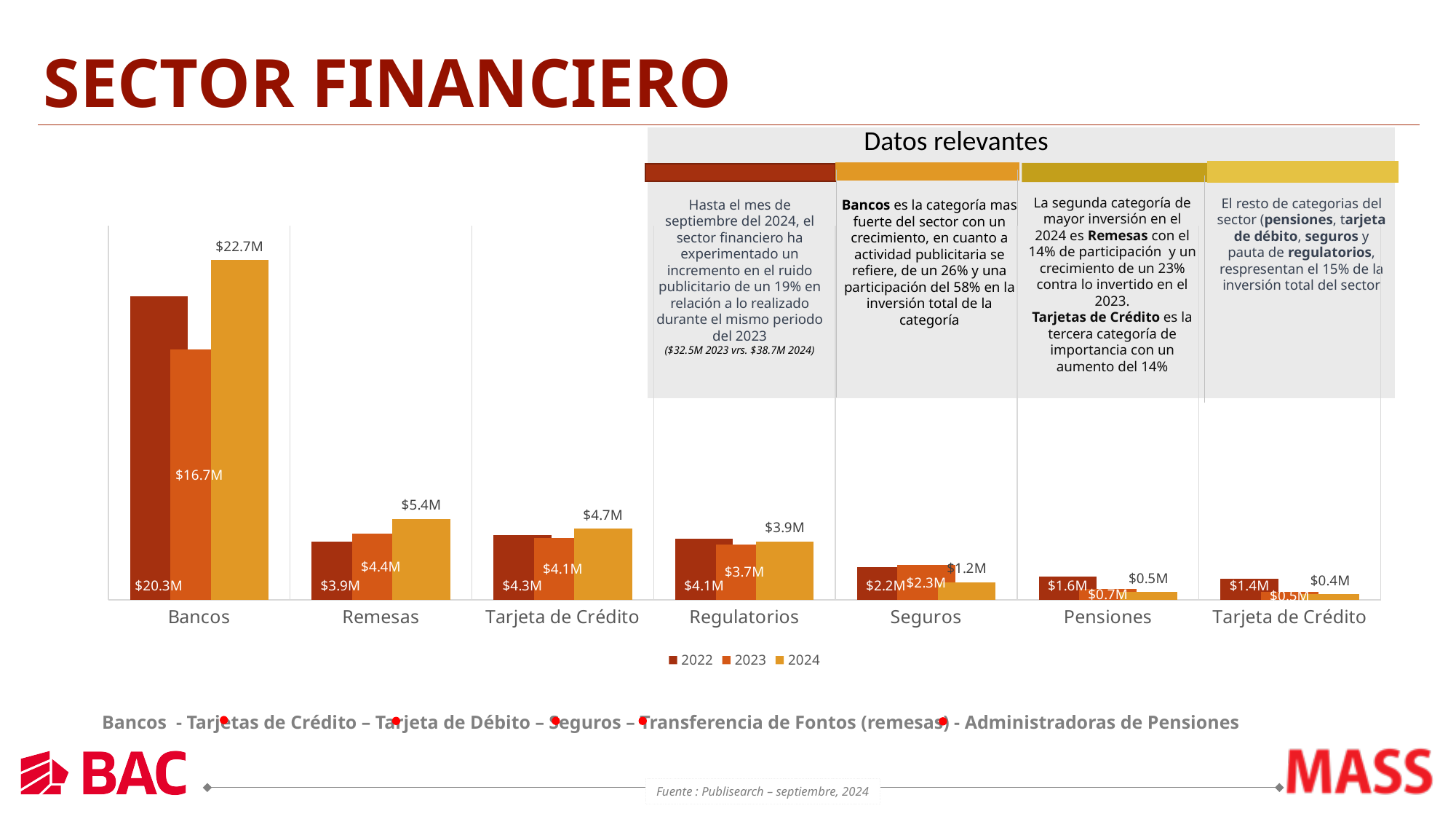
What is the 2024 value for Bancos? $22.7M What is the 2023 value for Remesas? $4.4M What is the difference between the 2024 and 2022 values for Remesas? $1.5M What kind of chart is shown on the slide? Bar chart What is the 2022 value for Pensiones? $1.6M For Regulatorios, which is larger: the 2022 value or the 2024 value? 2022 ($4.1M) What is the difference between the 2024 and 2023 values for Bancos? $6.0M How many categories are shown on the x axis of the chart? 7 Which category has the highest 2024 value? Bancos How many series does the legend list? 3 What is the 2024 value for Seguros? $1.2M Do the values for Pensiones rise or fall from 2022 to 2024? Fall